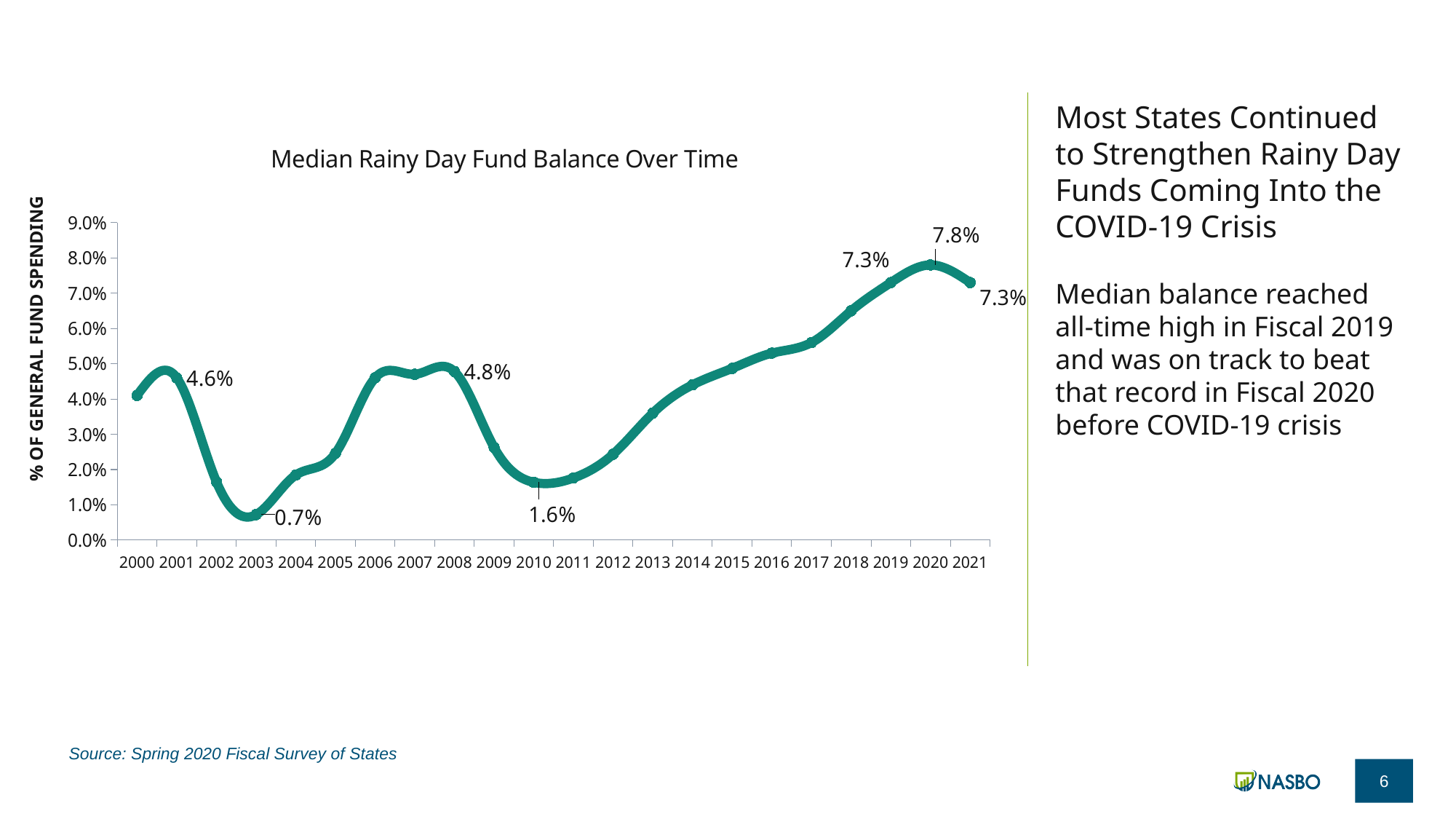
What value is labeled for 2003 on the chart? 0.7% Is the value for 2017 greater or less than 5.0%? greater Which is larger, the labeled value for 2001 or for 2008? 2008 What kind of chart is shown on the slide? Line chart Does the median balance rise or fall from 2010 to 2020? Rise What is the difference between the 2020 value and the 2003 value? 7.1 percentage points How many years are plotted on the x axis? 22 Which year has the highest median rainy day fund balance? 2020 What is the labeled value for 2010? 1.6% Which year has the lowest median rainy day fund balance? 2003 What is the median rainy day fund balance shown for 2020? 7.8% What is the labeled value for 2021? 7.3%